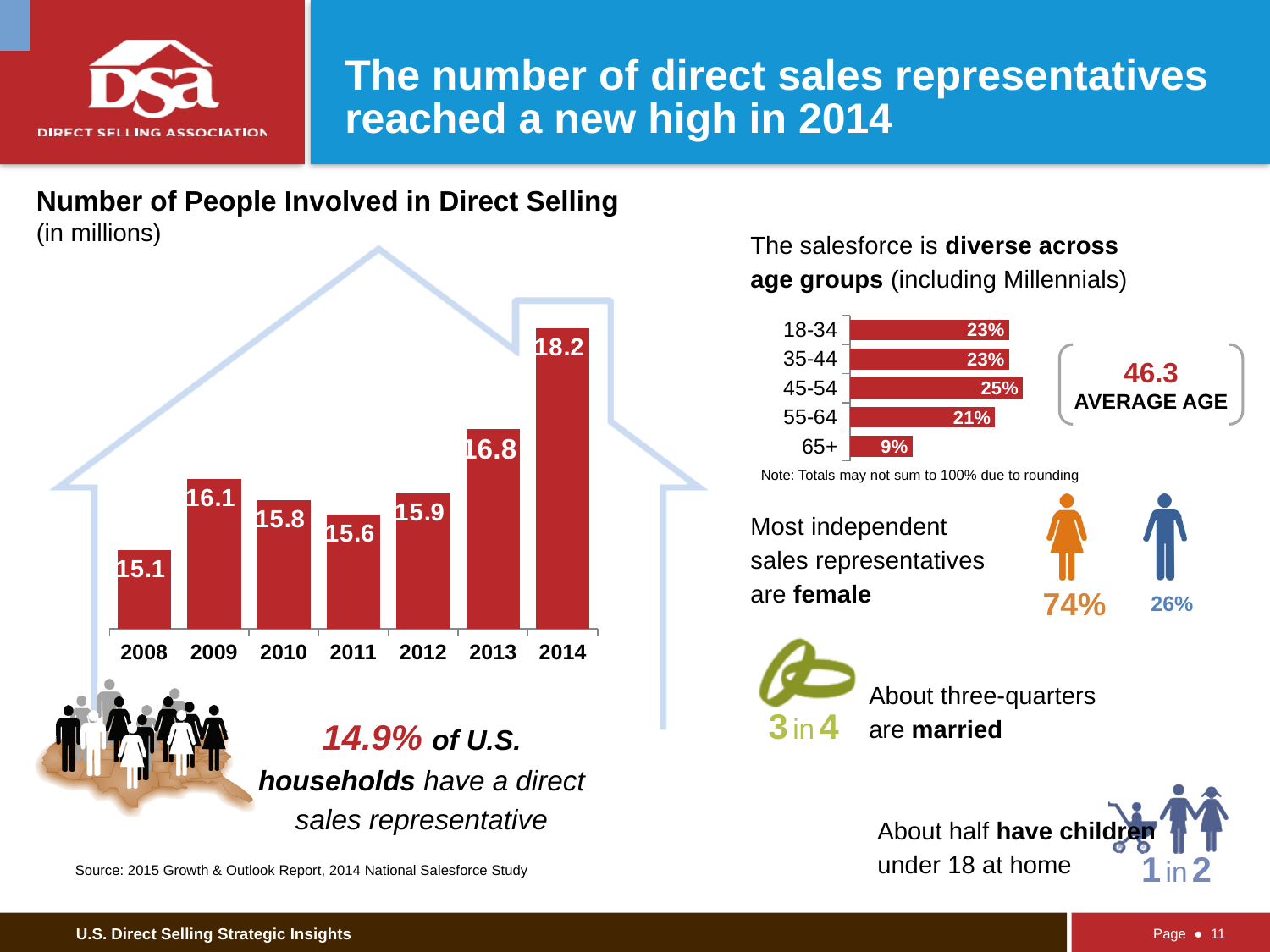
In the 'Number of People Involved in Direct Selling' chart, what is the difference between the 2014 and 2013 values? 1.4 In the 'Number of People Involved in Direct Selling' chart, what is the value for 2014? 18.2 How many age groups are shown in the age group chart on the right? 5 In the 'Number of People Involved in Direct Selling' chart, which is larger, the value for 2009 or the value for 2012? 2009 In the age group chart on the right, which age group has the lowest percentage? 65+ What kind of chart is the 'Number of People Involved in Direct Selling' chart? bar chart In the 'Number of People Involved in Direct Selling' chart, which year has the lowest value? 2008 In the 'Number of People Involved in Direct Selling' chart, which year has the highest value? 2014 In the age group chart on the right, what percentage is shown for the 45-54 group? 25% In the 'Number of People Involved in Direct Selling' chart, what is the value for 2011? 15.6 In the age group chart on the right, what is the difference between the 55-64 and 65+ percentages? 12% How many years are shown in the 'Number of People Involved in Direct Selling' chart? 7